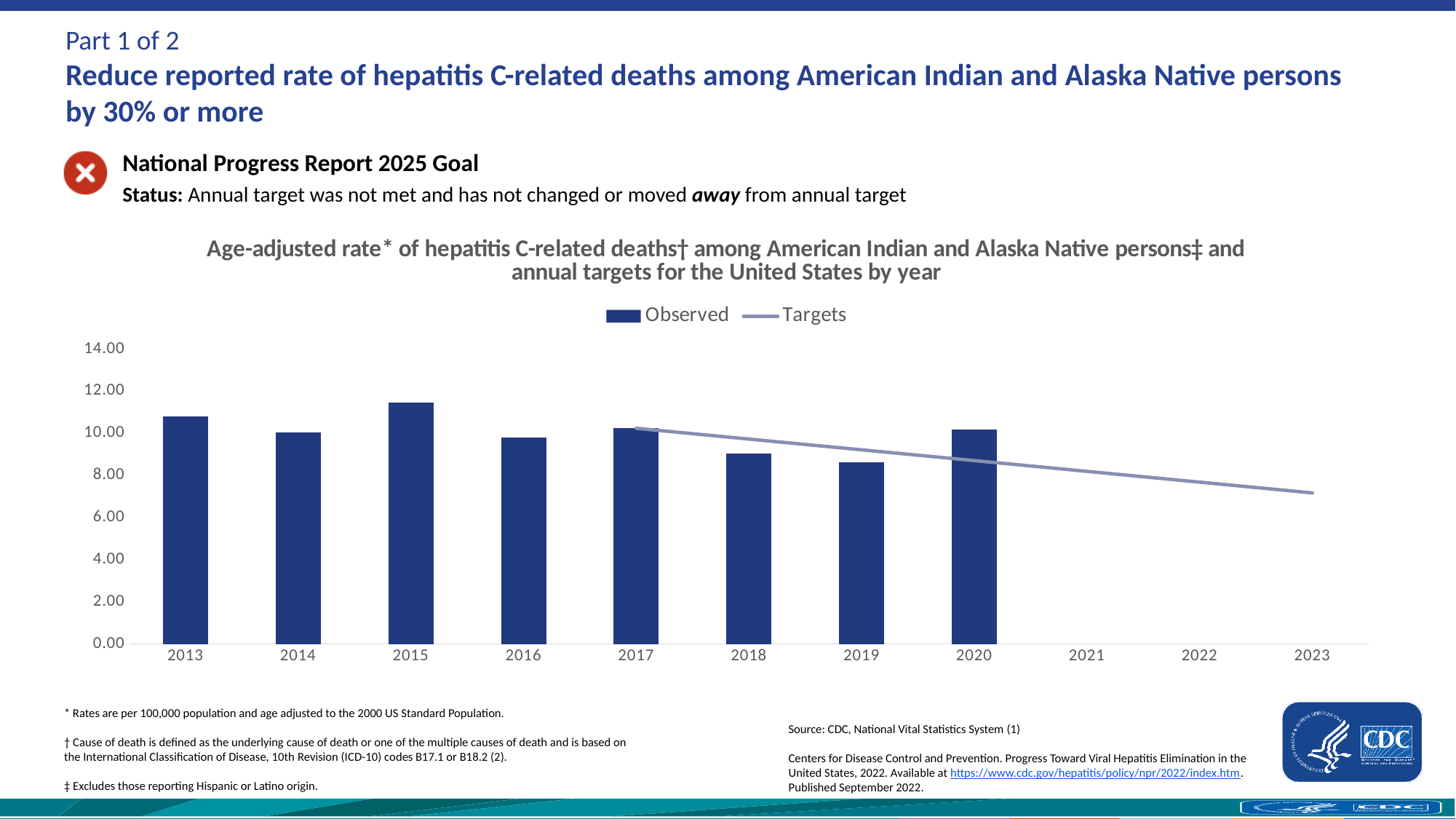
Which year has the highest Observed rate? 2015 Is the Observed value for 2015 greater or less than 10.00? greater What kind of chart is shown on the slide? bar and line chart How many years have an Observed bar plotted? 8 Which is larger, the Observed value for 2015 or for 2019? 2015 How many series does the legend list? 2 Is the Targets value for 2023 greater or less than 8.00? less Which year has the lowest Observed rate? 2019 What are the two series named in the legend? Observed and Targets Is the Observed value for 2013 greater or less than 10.00? greater How many years are shown on the x axis? 11